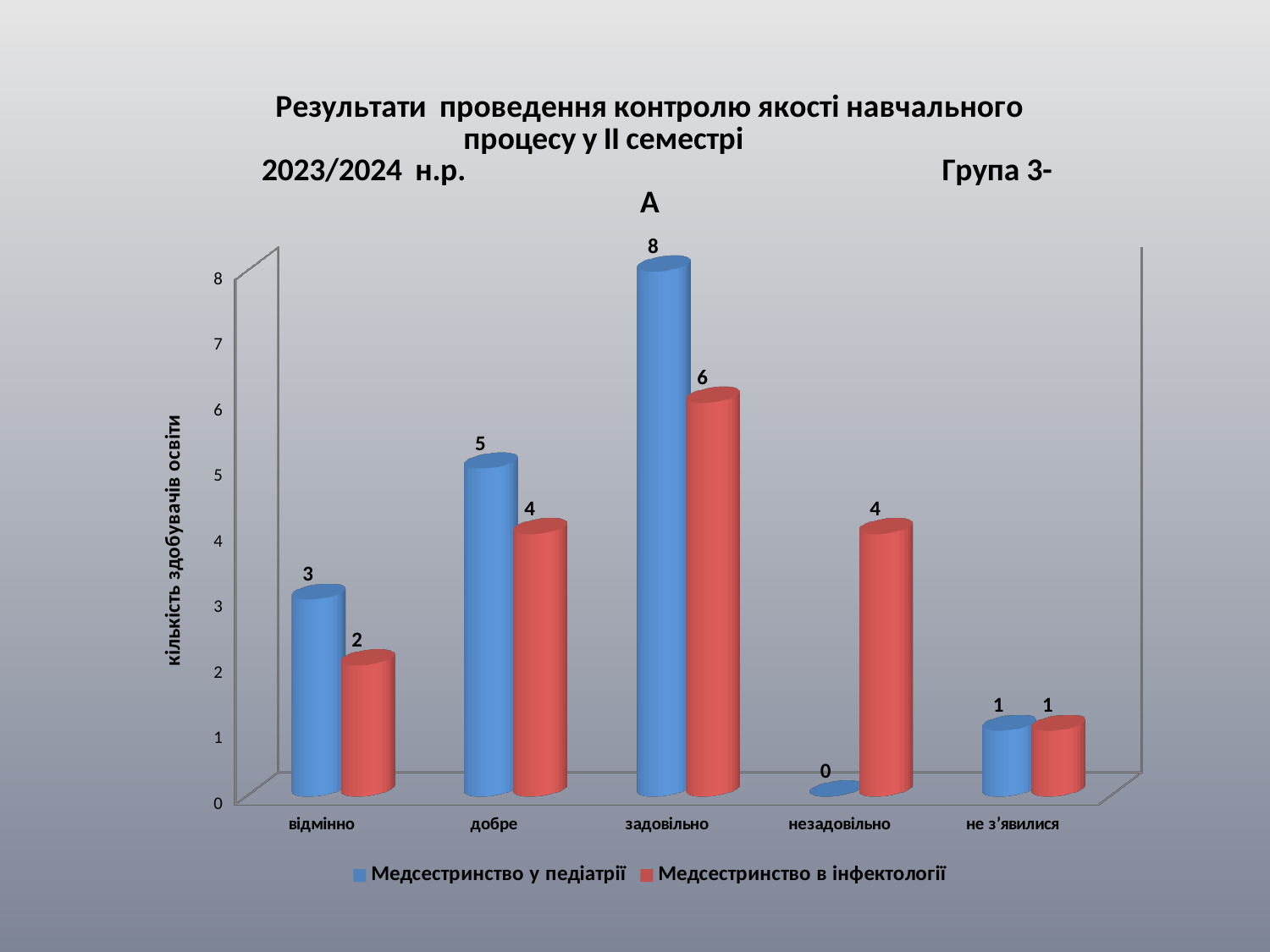
How many series does the legend list? 2 What is the value for "Медсестринство у педіатрії" in the "задовільно" category? 8 In the "задовільно" category, which series has the larger value? Медсестринство у педіатрії What is the value for "Медсестринство в інфектології" in the "відмінно" category? 2 What is the label of the vertical axis? кількість здобувачів освіти Which category has the highest value for "Медсестринство у педіатрії"? задовільно What is the difference between the two series in the "добре" category? 1 What kind of chart is shown on the slide? bar chart What is the total of the two series in the "не з’явилися" category? 2 How many categories are shown on the x axis? 5 Which category has the lowest value for "Медсестринство у педіатрії"? незадовільно What is the value for "Медсестринство в інфектології" in the "незадовільно" category? 4